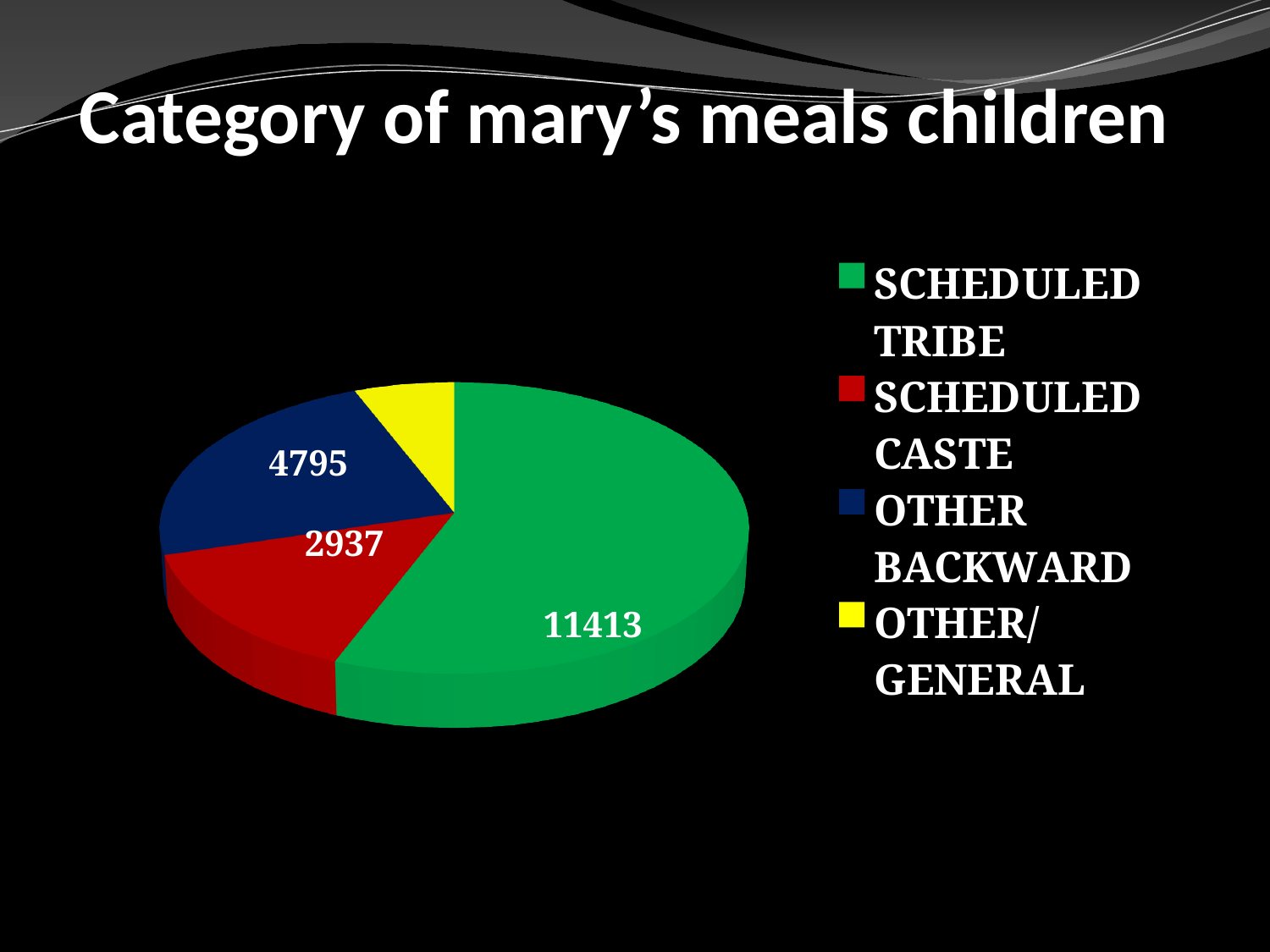
What is the value for SCHEDULED CASTE? 2937 How many categories does the pie chart show? 4 What is the value for OTHER BACKWARD? 4795 Which category has the smallest slice of the pie? OTHER/ GENERAL Which is larger, the value for OTHER BACKWARD or the value for SCHEDULED CASTE? OTHER BACKWARD What is the difference between the values for SCHEDULED TRIBE and OTHER BACKWARD? 6618 What kind of chart is shown on the slide? Pie chart Which colour represents SCHEDULED CASTE in the pie chart? Red Which category has the largest slice of the pie? SCHEDULED TRIBE What is the value for SCHEDULED TRIBE? 11413 What is the difference between the values for OTHER BACKWARD and SCHEDULED CASTE? 1858 What is the title of the chart? Category of mary's meals children